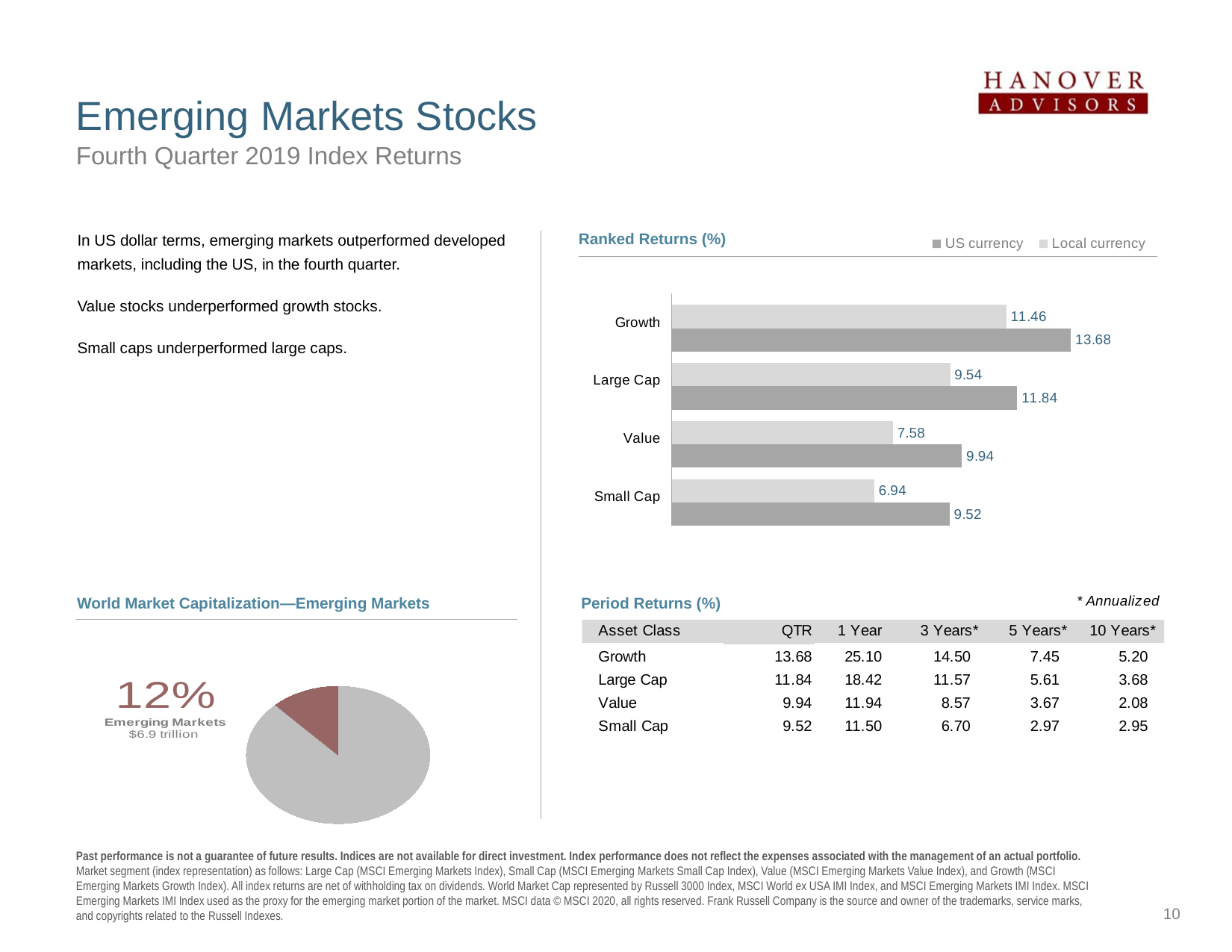
In the Ranked Returns (%) chart, what is the Local currency return for Value? 7.58 In the World Market Capitalization—Emerging Markets pie chart, what share of world market capitalization do emerging markets represent? 12% In the Ranked Returns (%) chart, which is larger: the US currency return for Value or the Local currency return for Large Cap? US currency return for Value In the Ranked Returns (%) chart, what is the Local currency return for Small Cap? 6.94 How many categories are shown in the Ranked Returns (%) chart? 4 How many series does the legend of the Ranked Returns (%) chart list? 2 In the Ranked Returns (%) chart, which category has the lowest Local currency return? Small Cap What kind of chart is the World Market Capitalization—Emerging Markets chart? Pie chart In the Ranked Returns (%) chart, what is the US currency return for Growth? 13.68 In the Ranked Returns (%) chart, which category has the highest US currency return? Growth In the Ranked Returns (%) chart, what is the difference between the US currency and Local currency returns for Large Cap? 2.30 What kind of chart is the Ranked Returns (%) chart? Bar chart